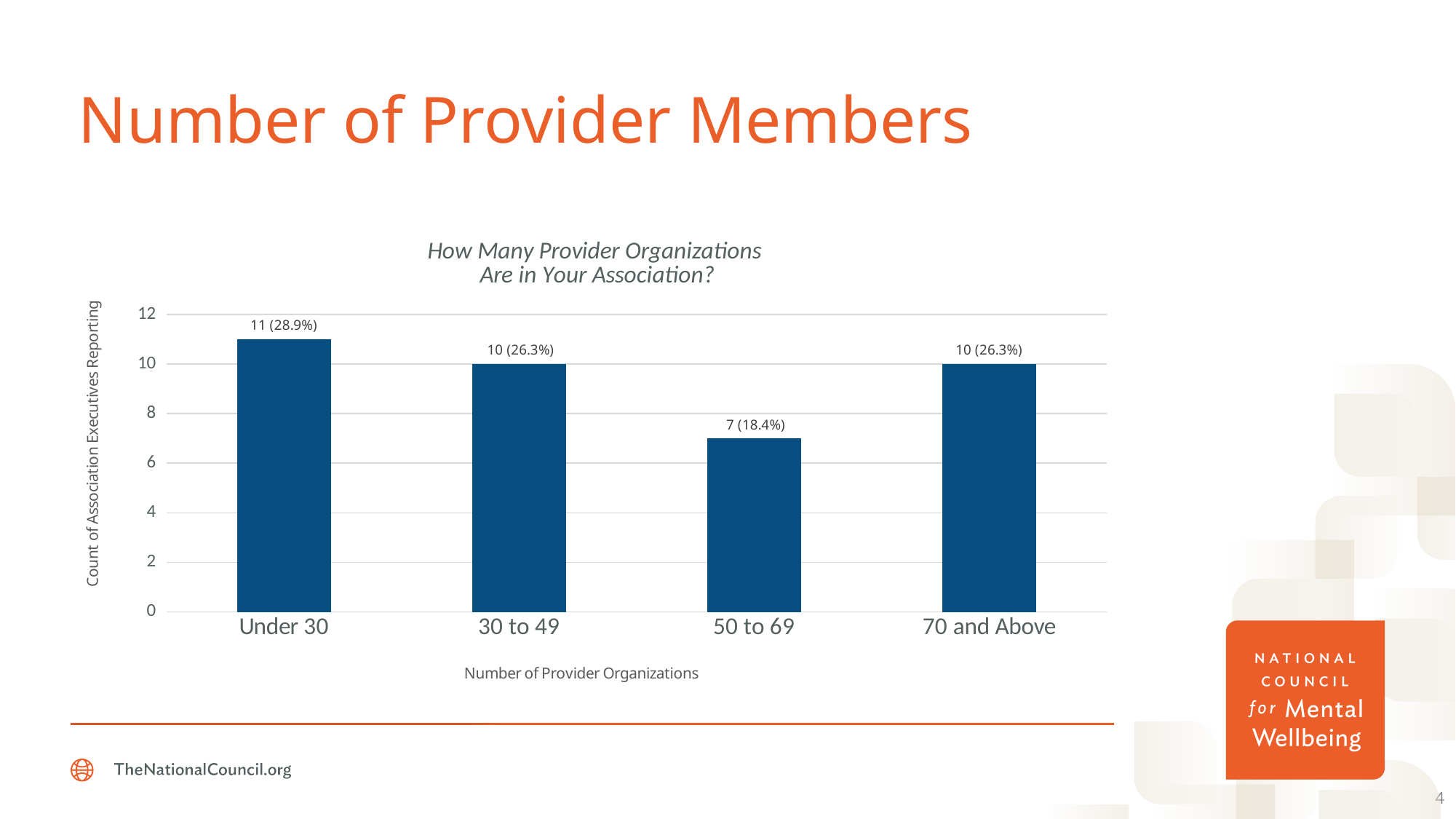
What kind of chart is shown on the slide? bar chart What is the title of the chart? How Many Provider Organizations Are in Your Association? What is the difference between the counts for 'Under 30' and '50 to 69'? 4 Is the value for '50 to 69' greater or less than 8? less What is the value for the '70 and Above' category? 10 (26.3%) What is the value for the 'Under 30' category? 11 (28.9%) Which is larger, the count for '30 to 49' or the count for '50 to 69'? 30 to 49 How many categories are shown on the x axis? 4 Which category has the lowest count of association executives reporting? 50 to 69 What is the label of the y axis? Count of Association Executives Reporting What is the value for the '50 to 69' category? 7 (18.4%) Which category has the highest count of association executives reporting? Under 30